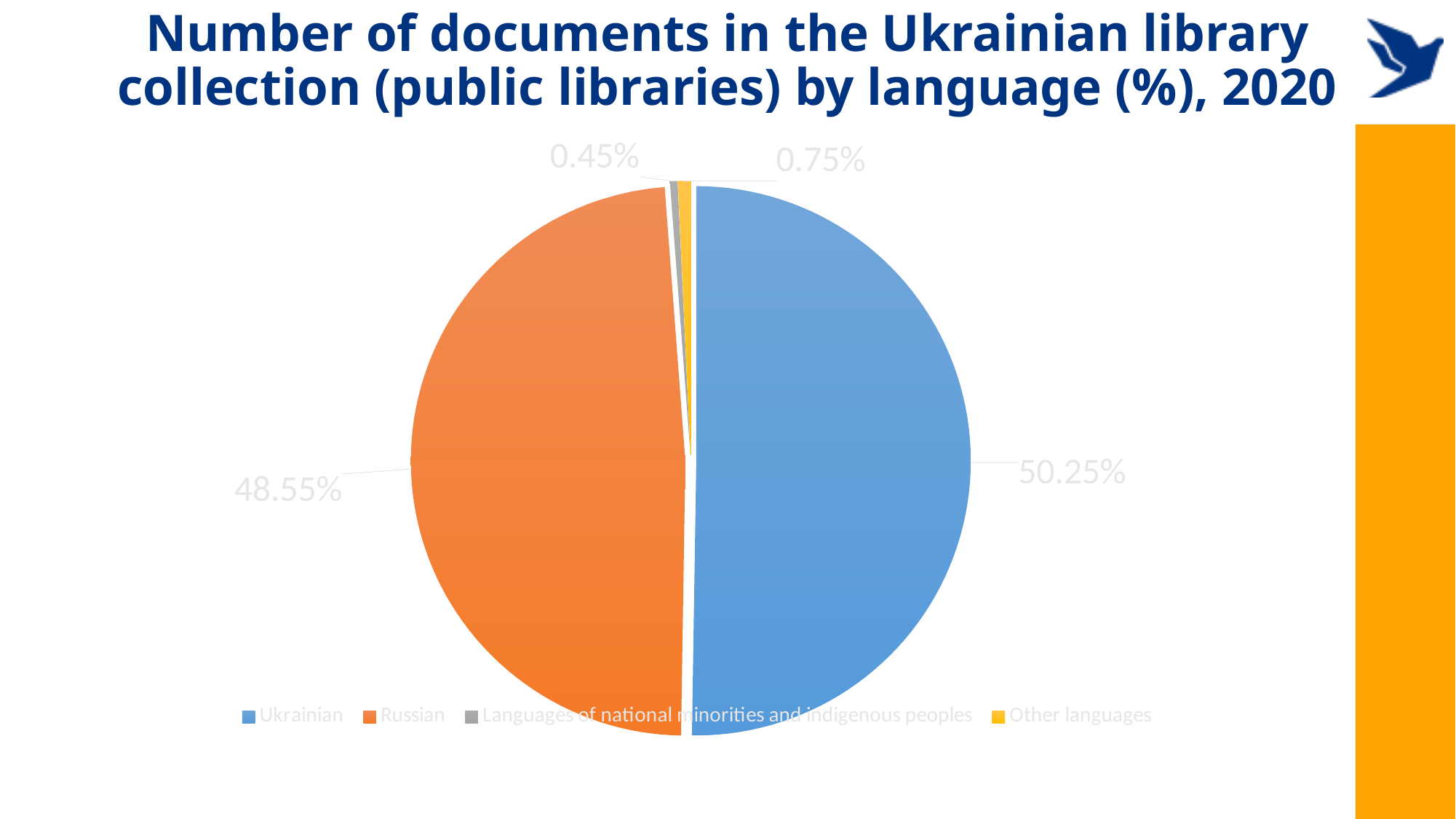
What share of the pie does Other languages hold? 0.75% What share of the pie does Ukrainian hold? 50.25% How many slices does the pie chart have? 4 Which colour represents Russian in the pie chart? Orange What is the combined share of Ukrainian and Russian documents? 98.80% Which language has the smallest share of documents? Languages of national minorities and indigenous peoples What share of the pie does Languages of national minorities and indigenous peoples hold? 0.45% What is the difference between the Ukrainian and Russian shares? 1.70% What share of the pie does Russian hold? 48.55% Which is larger, the share for Other languages or the share for Languages of national minorities and indigenous peoples? Other languages Which language has the largest share of documents? Ukrainian What kind of chart is shown on the slide? Pie chart